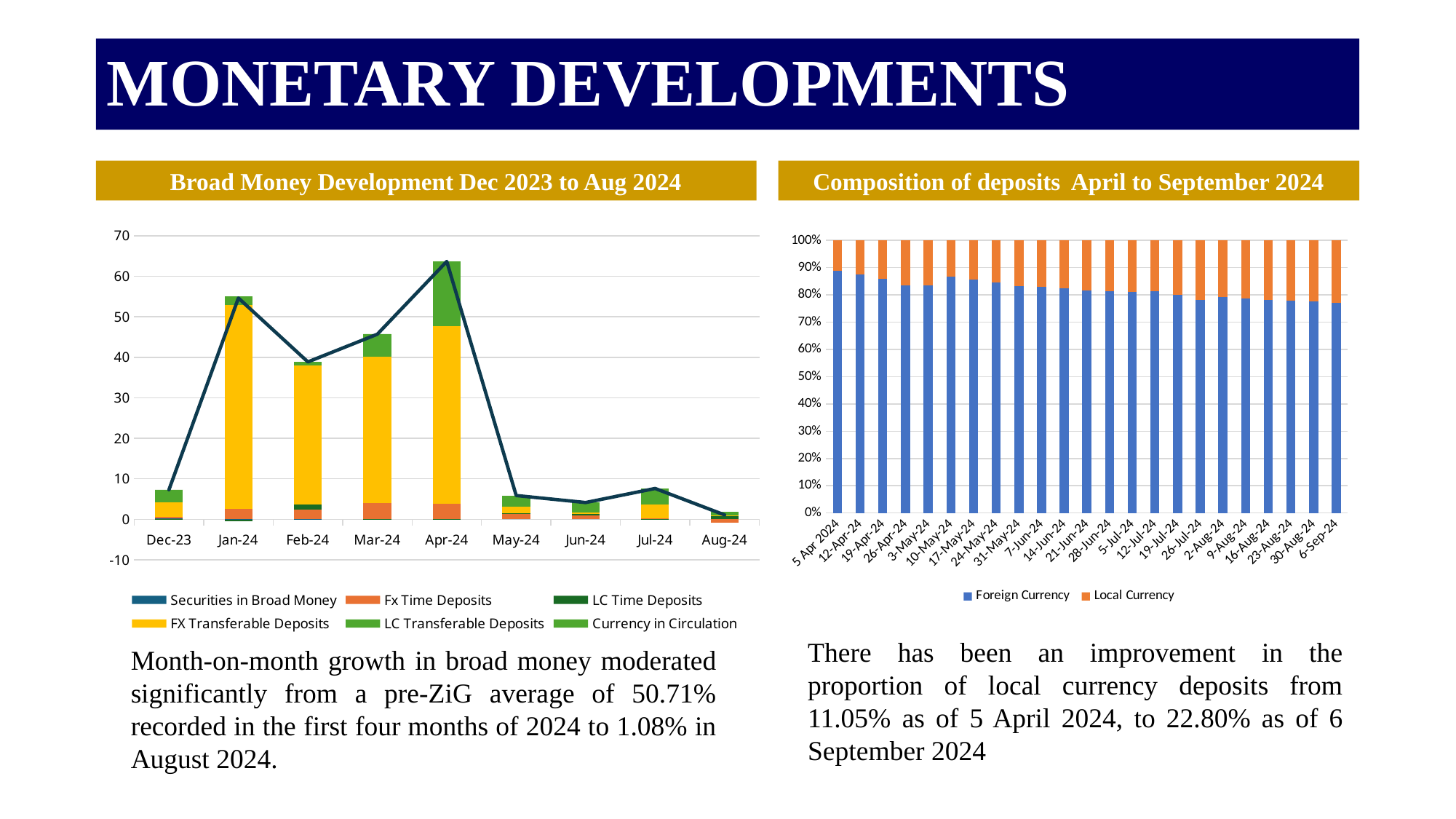
On the 'Composition of deposits April to September 2024' chart, is the Foreign Currency share on 5 Apr 2024 greater or less than 80%? greater On the 'Composition of deposits April to September 2024' chart, how many series does the legend list? 2 On the 'Broad Money Development Dec 2023 to Aug 2024' chart, which stacked bar is taller, Jan-24 or Feb-24? Jan-24 On the 'Broad Money Development Dec 2023 to Aug 2024' chart, how many months are shown on the x axis? 9 On the 'Composition of deposits April to September 2024' chart, does the Foreign Currency share rise or fall from 5 Apr 2024 to 6-Sep-24? fall On the 'Broad Money Development Dec 2023 to Aug 2024' chart, how many series does the legend list? 6 On the 'Broad Money Development Dec 2023 to Aug 2024' chart, is the total stacked bar for Apr-24 greater or less than 60? greater On the 'Broad Money Development Dec 2023 to Aug 2024' chart, which month has the tallest stacked bar? Apr-24 On the 'Composition of deposits April to September 2024' chart, how many dates are shown on the x axis? 23 What kind of chart is 'Composition of deposits April to September 2024'? Stacked bar chart On the 'Broad Money Development Dec 2023 to Aug 2024' chart, is the total stacked bar for Jan-24 greater or less than 50? greater On the 'Broad Money Development Dec 2023 to Aug 2024' chart, which series is shown in yellow? FX Transferable Deposits